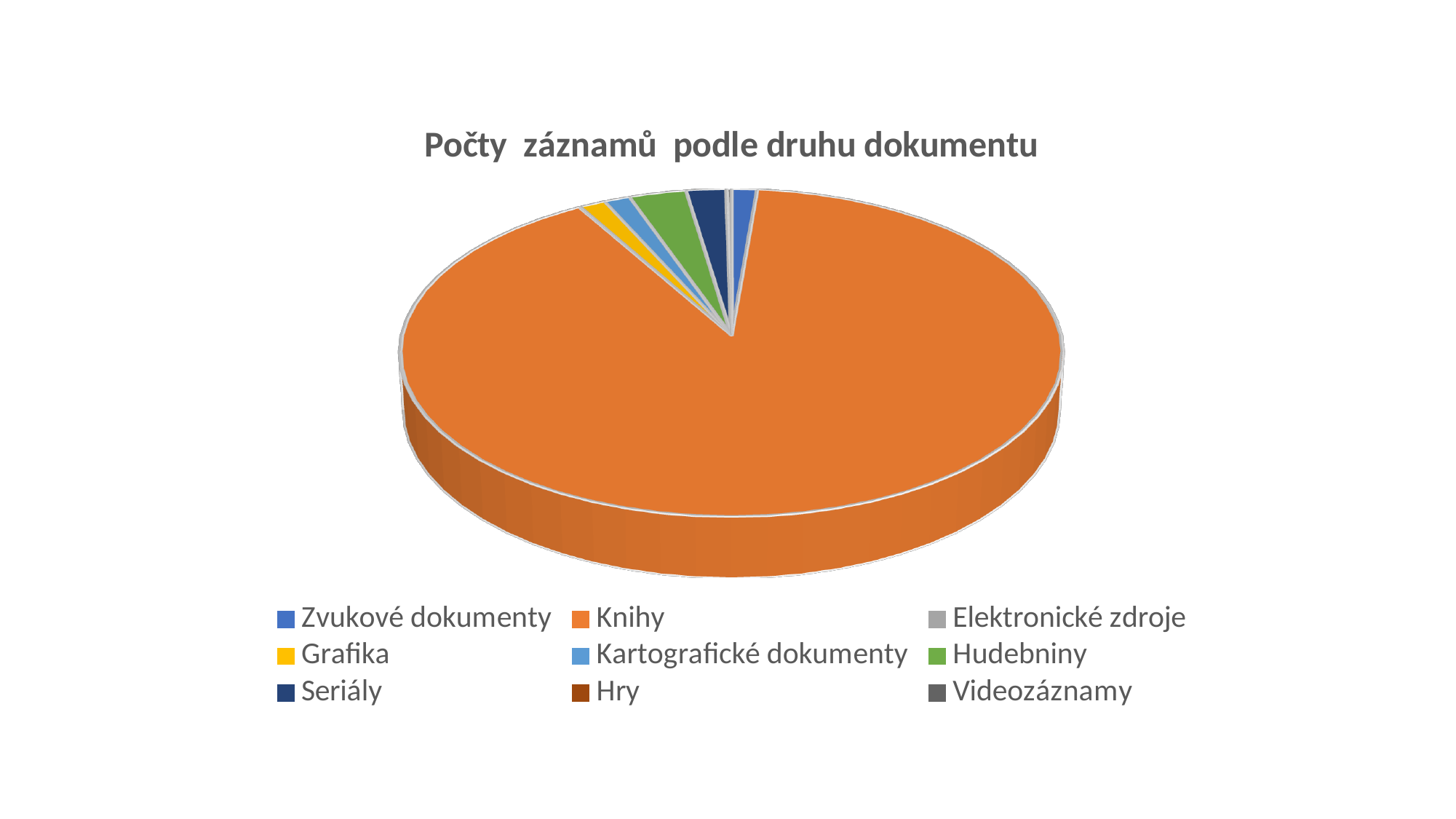
Does the Knihy slice make up more or less than half of the pie? more What colour is the Knihy slice in the pie chart? orange Which category has the largest slice of the pie? Knihy Which slice is larger, Hudebniny or Grafika? Hudebniny How many categories does the legend of the pie chart list? 9 Which slice is larger, Knihy or Zvukové dokumenty? Knihy Which slice is larger, Knihy or Hudebniny? Knihy What is the title of the chart? Počty záznamů podle druhu dokumentu What kind of chart is shown on the slide? pie chart